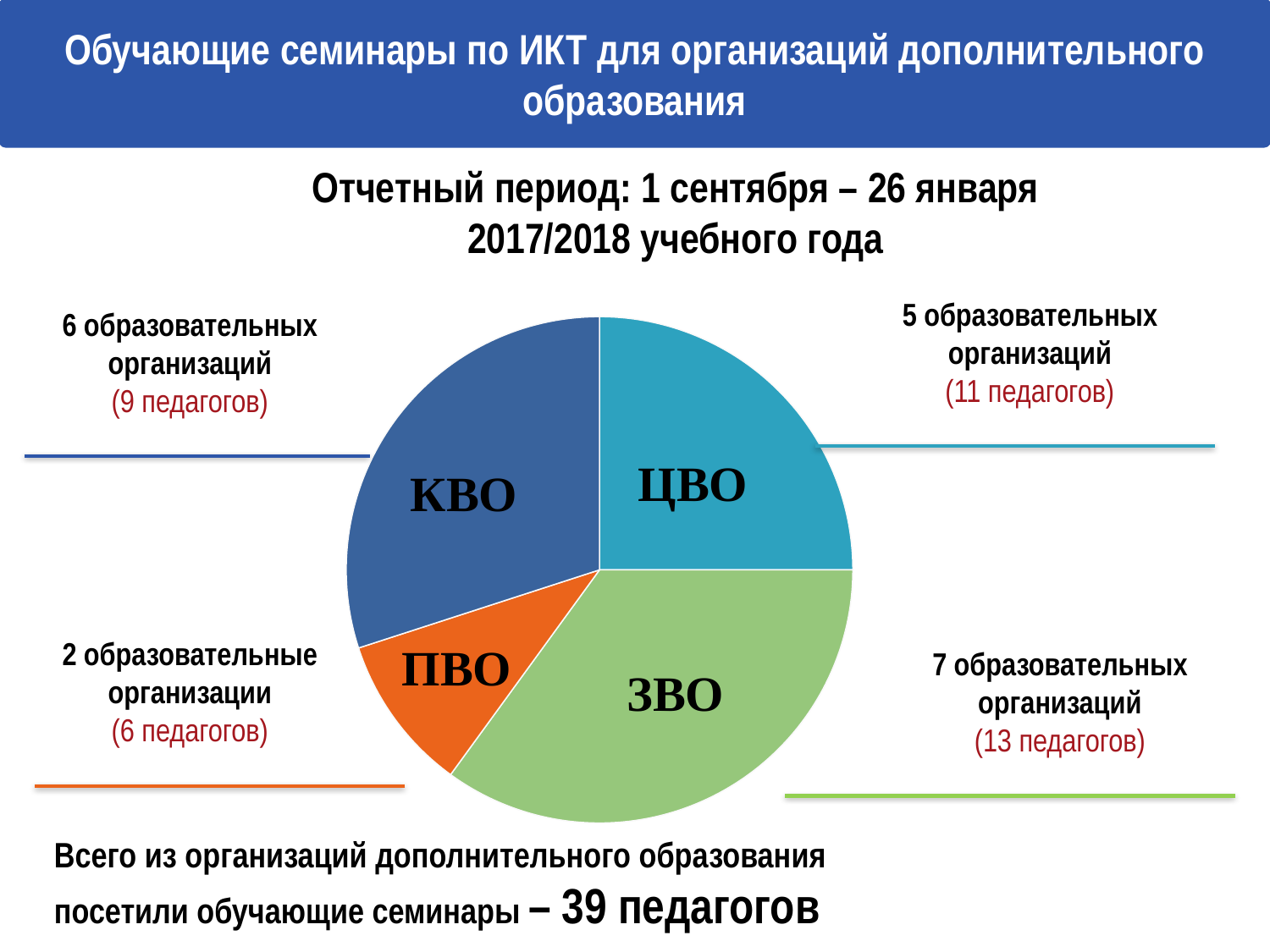
What is the total number of педагогов across all slices, as stated on the slide? 39 педагогов Which slice of the pie chart is the smallest? ПВО How many педагогов are shown for the ЗВО slice? 13 педагогов What is the difference in the number of педагогов between ЗВО and ПВО? 7 How many образовательных организаций are shown for the КВО slice? 6 How many педагогов are shown for the ПВО slice? 6 педагогов How many slices does the pie chart have? 4 What colour is the ПВО slice of the pie chart? orange How many образовательных организаций are shown for the ЦВО slice? 5 What kind of chart is shown on the slide? pie chart Which slice has more педагогов, ЦВО or КВО? ЦВО Which slice of the pie chart is the largest? ЗВО